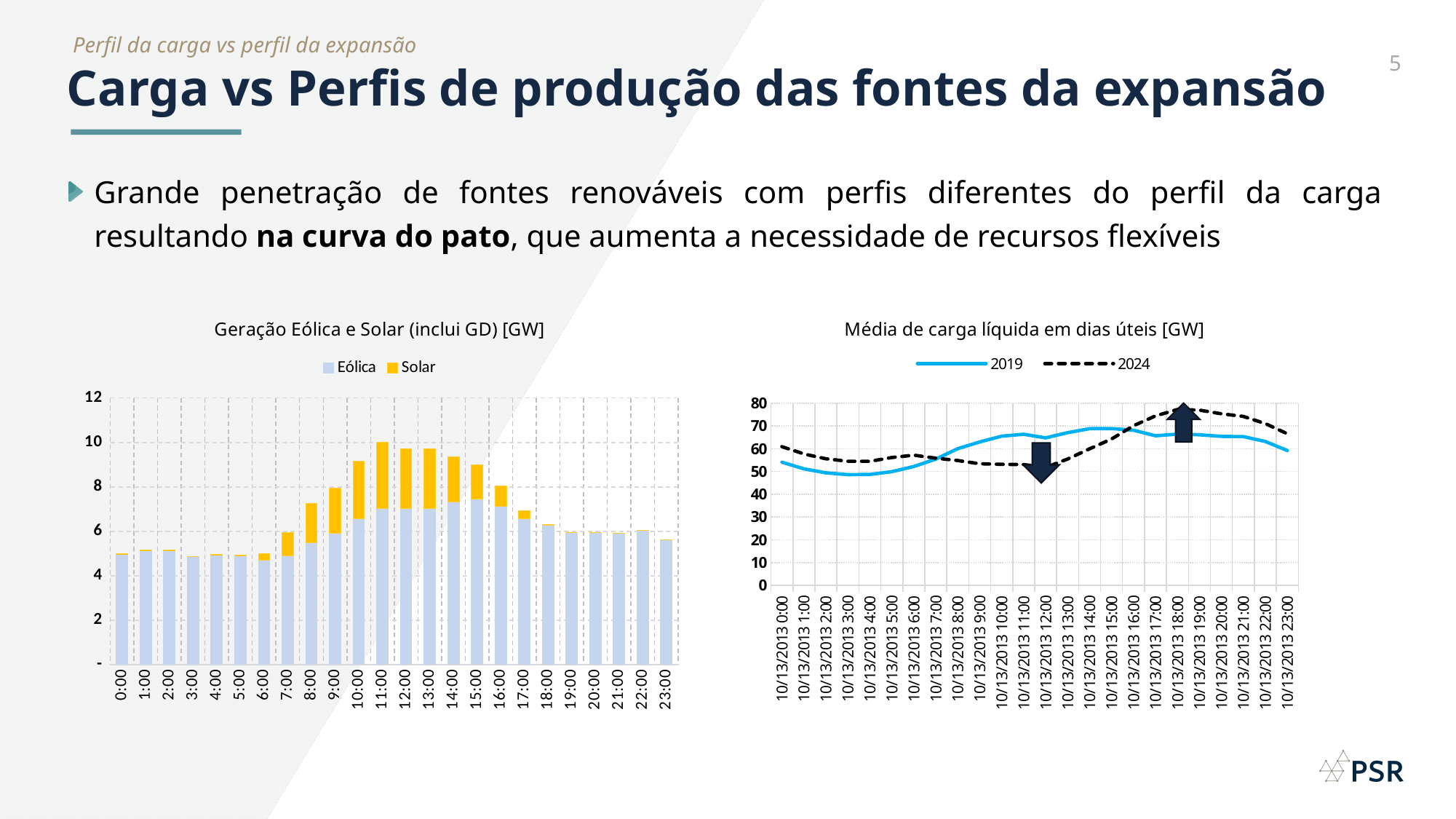
What kind of chart is the 'Geração Eólica e Solar (inclui GD) [GW]' chart? Bar chart How many series does the legend of the 'Média de carga líquida em dias úteis [GW]' chart list? 2 In the 'Média de carga líquida em dias úteis [GW]' chart, does the 2019 line rise or fall from 10/13/2013 0:00 to 10/13/2013 3:00? Fall In the 'Geração Eólica e Solar (inclui GD) [GW]' chart, at which hour is the total stacked bar highest? 11:00 In the 'Média de carga líquida em dias úteis [GW]' chart, which series has the larger value at 10/13/2013 12:00, 2019 or 2024? 2019 How many series does the legend of the 'Geração Eólica e Solar (inclui GD) [GW]' chart list? 2 In the 'Geração Eólica e Solar (inclui GD) [GW]' chart, is the total bar at 11:00 greater or less than 8? greater In the 'Geração Eólica e Solar (inclui GD) [GW]' chart, is the total bar at 0:00 greater or less than 6? less How many hourly categories are shown on the x axis of the 'Geração Eólica e Solar (inclui GD) [GW]' chart? 24 In the 'Média de carga líquida em dias úteis [GW]' chart, is the 2024 value at 10/13/2013 18:00 greater or less than 70? greater What kind of chart is the 'Média de carga líquida em dias úteis [GW]' chart? Line chart In the 'Geração Eólica e Solar (inclui GD) [GW]' chart, which colour represents the Solar series? Yellow